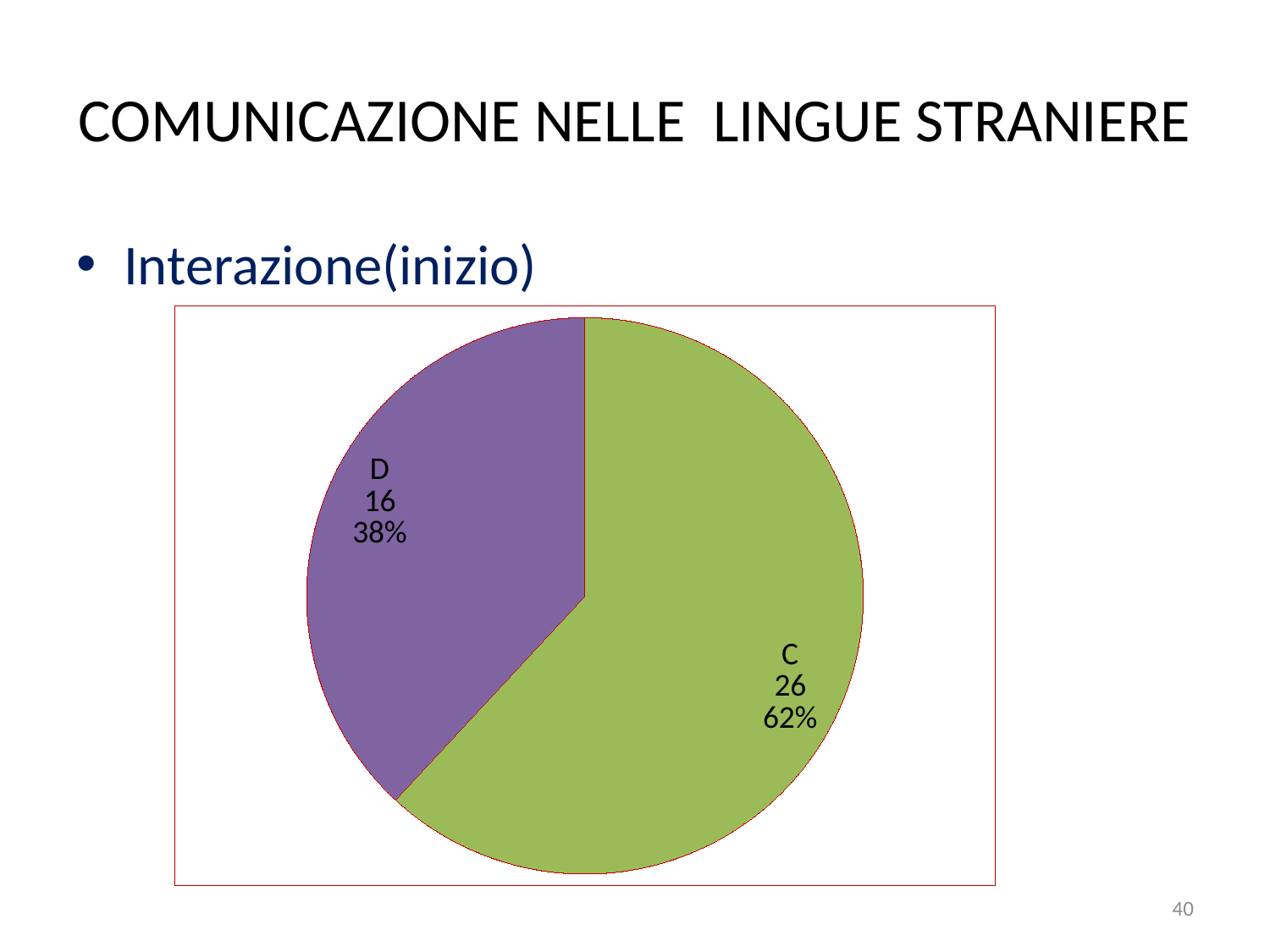
What is the value for category D? 16 What is the value for category C? 26 What percentage share of the pie does slice C represent? 62% Which is larger, the value for C or the value for D? C What colour is the slice for category D? purple Which category has the largest slice? C What is the difference between the values for C and D? 10 What is the total of the values for C and D? 42 What kind of chart is shown on the slide? pie chart Which category has the smallest slice? D How many slices does the pie chart have? 2 What percentage share of the pie does slice D represent? 38%